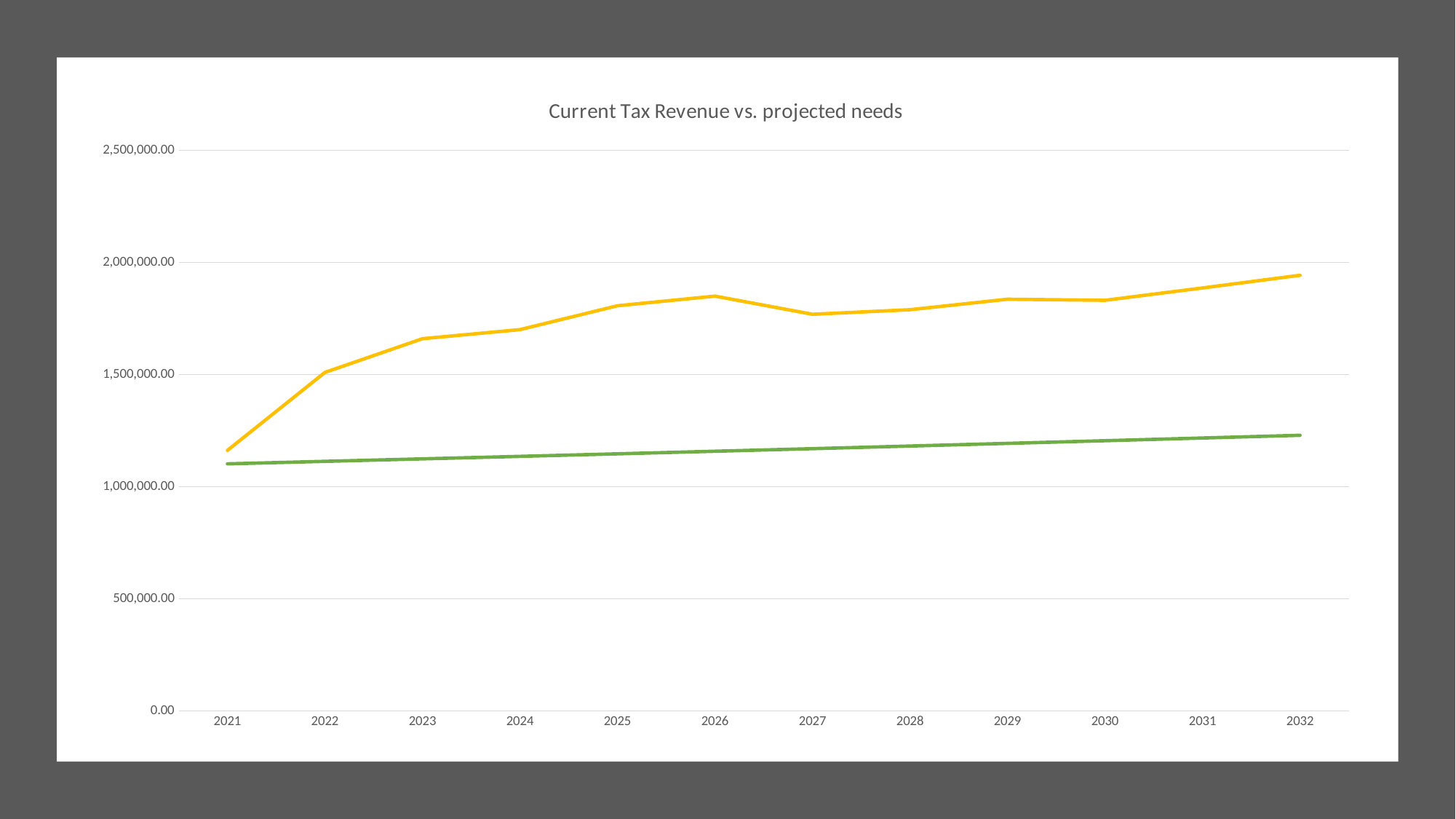
What is the title of the chart? Current Tax Revenue vs. projected needs In which year does the green line have its lowest value? 2021 In which year does the yellow line have its lowest value? 2021 What kind of chart is shown on the slide? line chart How many lines are plotted on the chart? 2 In which year does the yellow line reach its highest value? 2032 Is the value of the yellow line in 2021 greater or less than 1,500,000.00? less How many years are shown along the x axis of the chart? 12 Is the value of the green line in 2032 greater or less than 1,500,000.00? less In 2026, which line has the higher value, the yellow line or the green line? the yellow line Is the value of the yellow line in 2026 greater or less than 1,500,000.00? greater